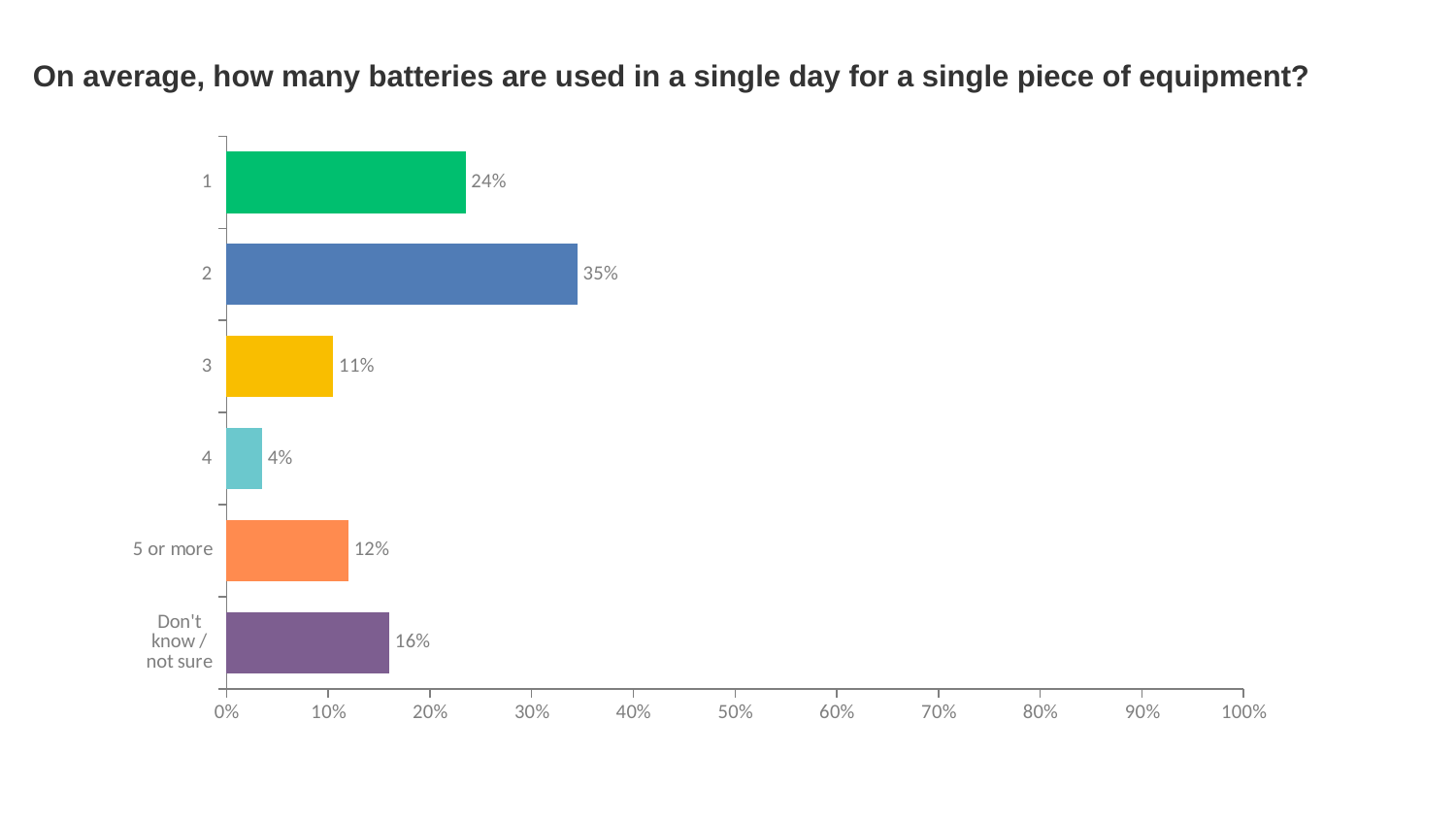
Is the value for 1 battery greater or less than 20%? greater What is the value shown for the '5 or more' category? 12% Which category has the lowest percentage? 4 What is the difference between the percentages for 2 batteries and 1 battery? 11% Which is larger, the value for 3 batteries or the value for '5 or more'? 5 or more What percentage of respondents said 2 batteries are used in a single day for a single piece of equipment? 35% What is the difference between the values for 4 batteries and 3 batteries? 7% How many categories are shown on the chart? 6 What is the title of the chart? On average, how many batteries are used in a single day for a single piece of equipment? What kind of chart is shown on the slide? Bar chart What percentage of respondents answered 'Don't know / not sure'? 16% Which category has the highest percentage? 2